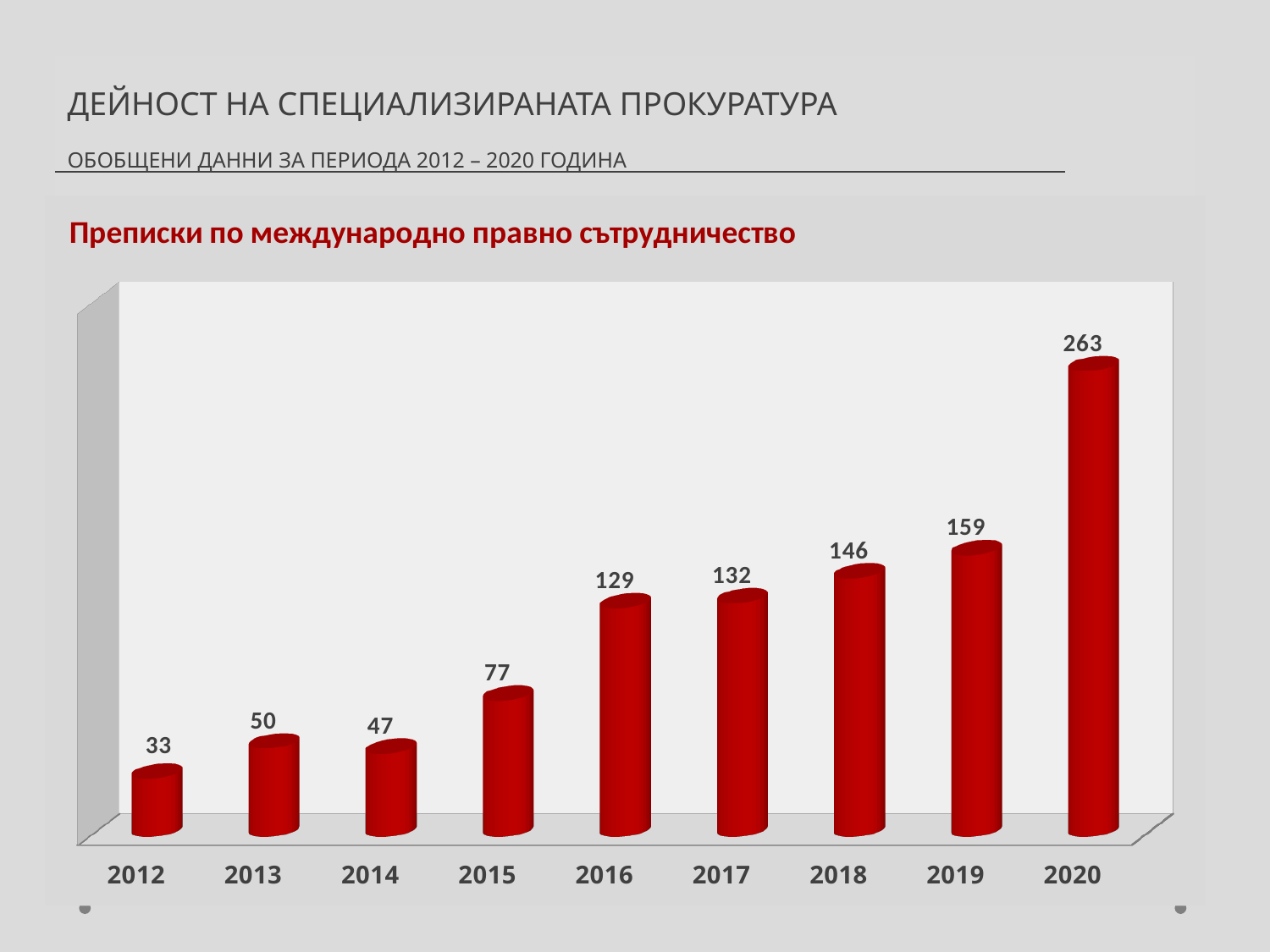
What is the difference between the values for 2015 and 2014? 30 Which year has the lowest value? 2012 Which is larger, the value for 2013 or the value for 2014? 2013 What is the value for 2016? 129 How many years are shown on the x axis? 9 What is the title of the chart? Преписки по международно правно сътрудничество What is the value for 2012? 33 What kind of chart is shown on the slide? bar chart Do the values generally rise or fall from 2014 to 2020? rise Which year has the highest value? 2020 What is the difference between the values for 2020 and 2019? 104 What is the value for 2019? 159